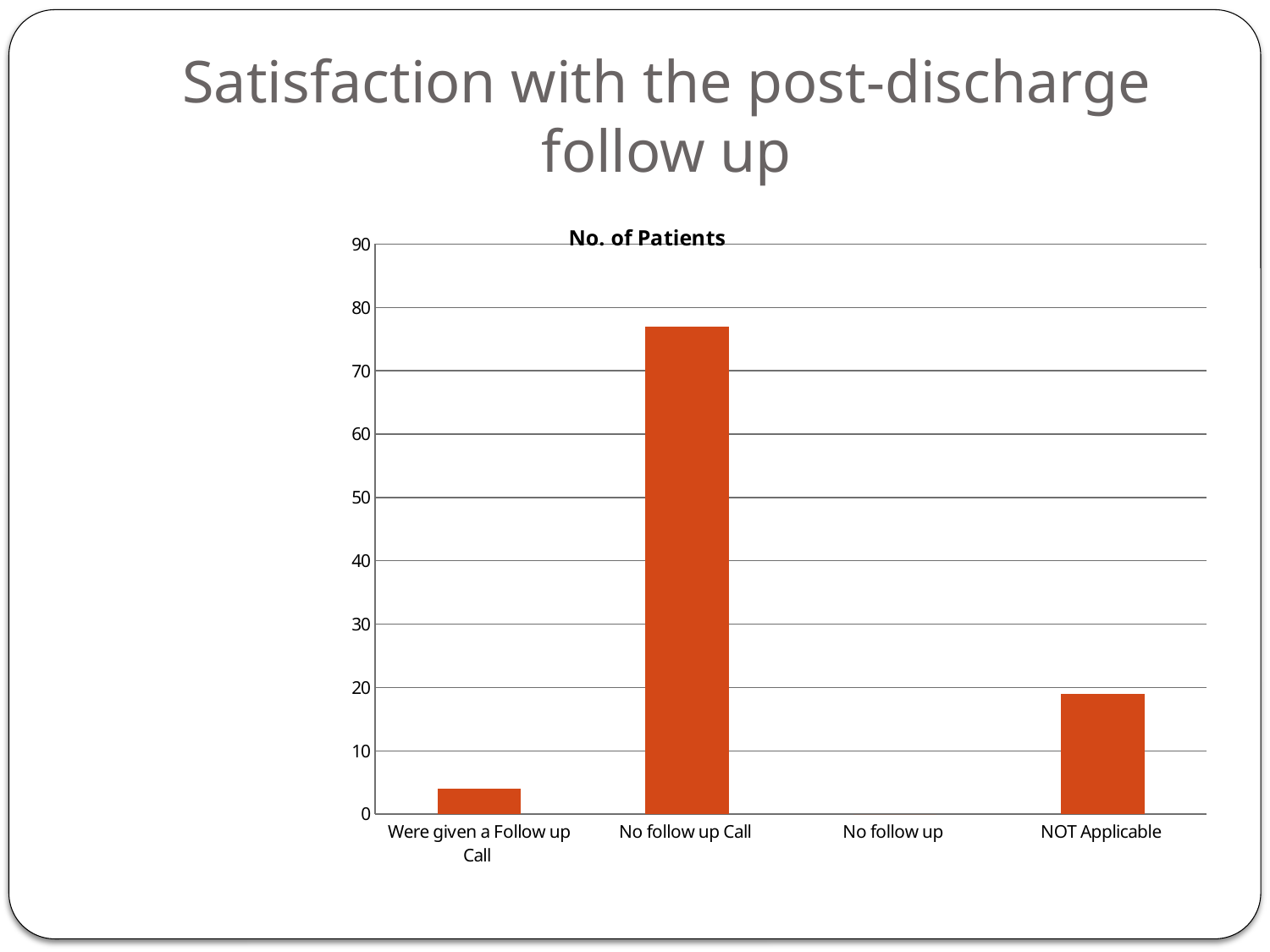
Which is larger, the value for NOT Applicable or the value for Were given a Follow up Call? NOT Applicable Is the value for No follow up Call greater or less than 80? less Which category has the highest number of patients? No follow up Call Is the value for NOT Applicable greater or less than 10? greater Is the value for Were given a Follow up Call greater or less than 10? less How many categories are shown on the x axis of the chart? 4 What is the highest value shown on the vertical axis of the chart? 90 Which category has the lowest number of patients? No follow up What kind of chart is shown on the slide? bar chart What is the title of the chart? No. of Patients